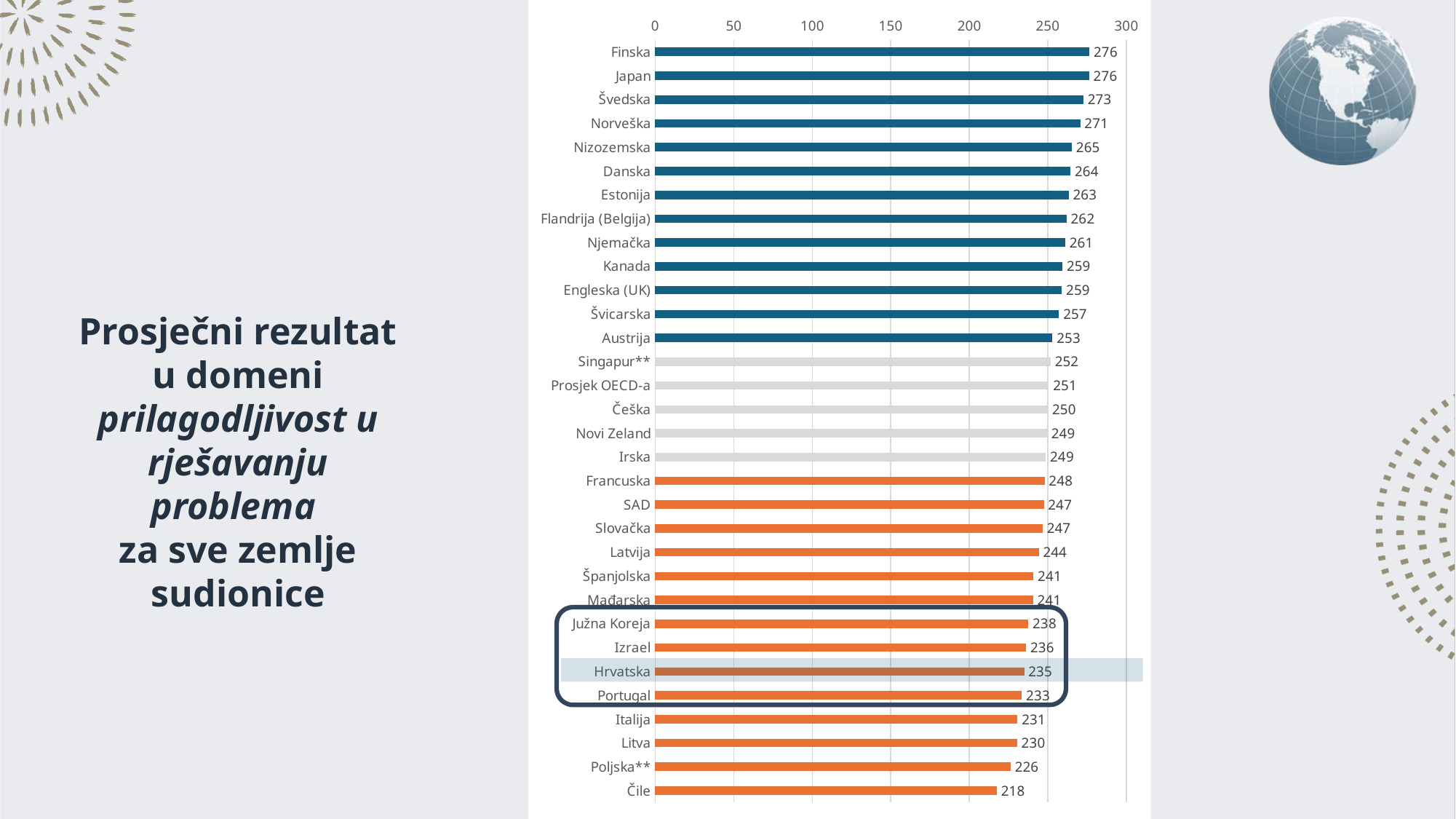
What colour are the bars for the countries with the highest values, such as Finska and Japan? Dark blue Is the value for Poljska** greater or less than 250? less What is the difference between the values for Prosjek OECD-a and Hrvatska? 16 What is the value for Prosjek OECD-a? 251 Which has a larger value, Švedska or Austrija? Švedska How many categories are shown in the chart? 32 What is the difference between the values for Finska and Čile? 58 What is the value for Njemačka? 261 What kind of chart is shown on the slide? Bar chart Which has a larger value, Portugal or Latvija? Latvija Which category has the lowest value? Čile What is the value for Hrvatska? 235